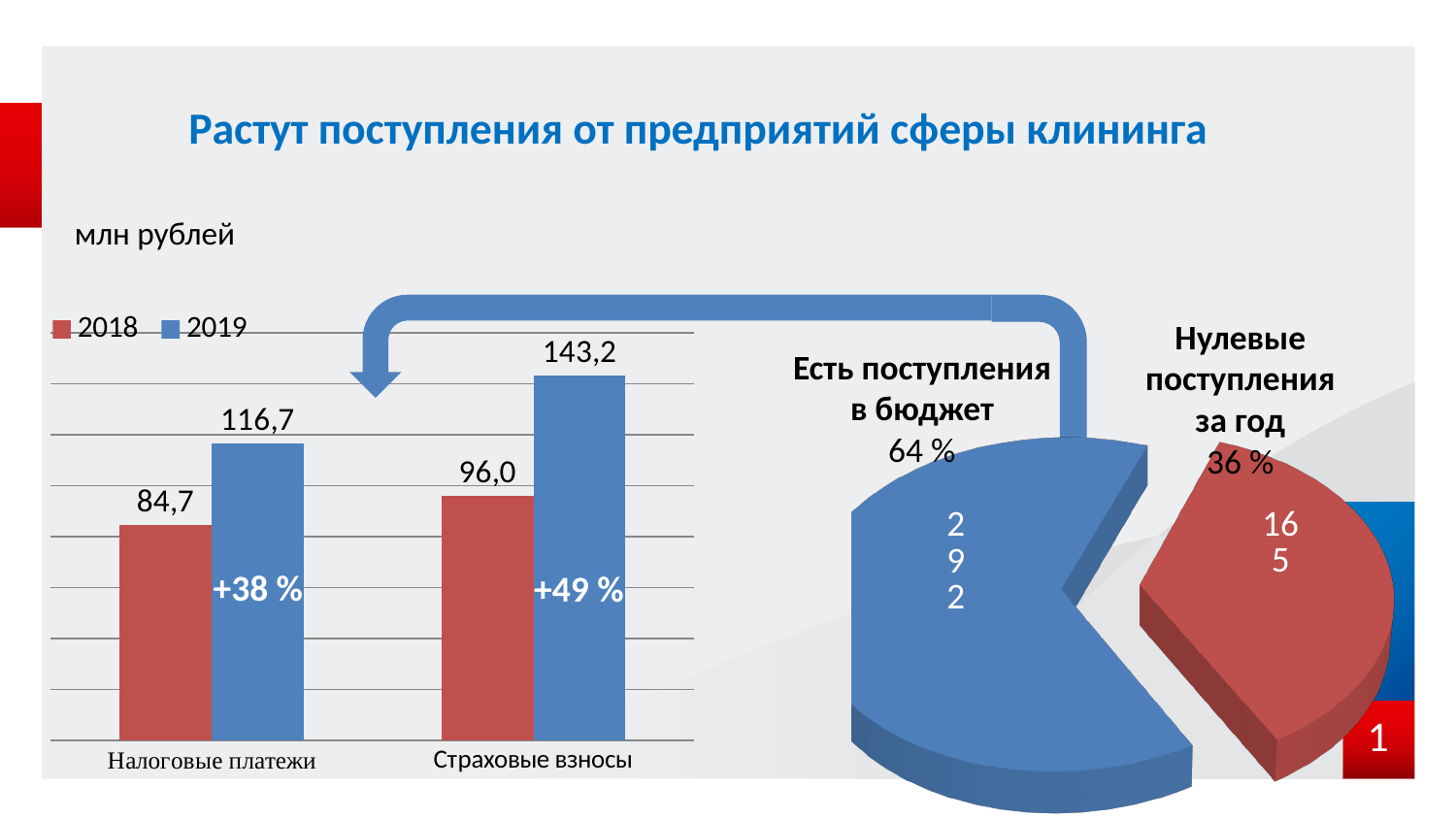
In the bar chart on the left, what is the value for Налоговые платежи in 2019? 116,7 In the bar chart on the left, what is the difference between the 2019 and 2018 values for Страховые взносы? 47,2 In the bar chart on the left, what is the value for Налоговые платежи in 2018? 84,7 What type of chart is shown on the left of the slide? Bar chart In the bar chart on the left, what percentage growth is labelled for Налоговые платежи? +38 % In the pie chart on the right, what share is labelled for Есть поступления в бюджет? 64 % How many series does the legend of the bar chart on the left list? 2 In the bar chart on the left, what is the value for Страховые взносы in 2018? 96,0 In the bar chart on the left, which bar has the highest value? Страховые взносы, 2019 In the bar chart on the left, which bar has the lowest value? Налоговые платежи, 2018 In the pie chart on the right, what value is shown for Нулевые поступления за год? 165 In the bar chart on the left, which is larger: Налоговые платежи in 2019 or Страховые взносы in 2018? Налоговые платежи in 2019